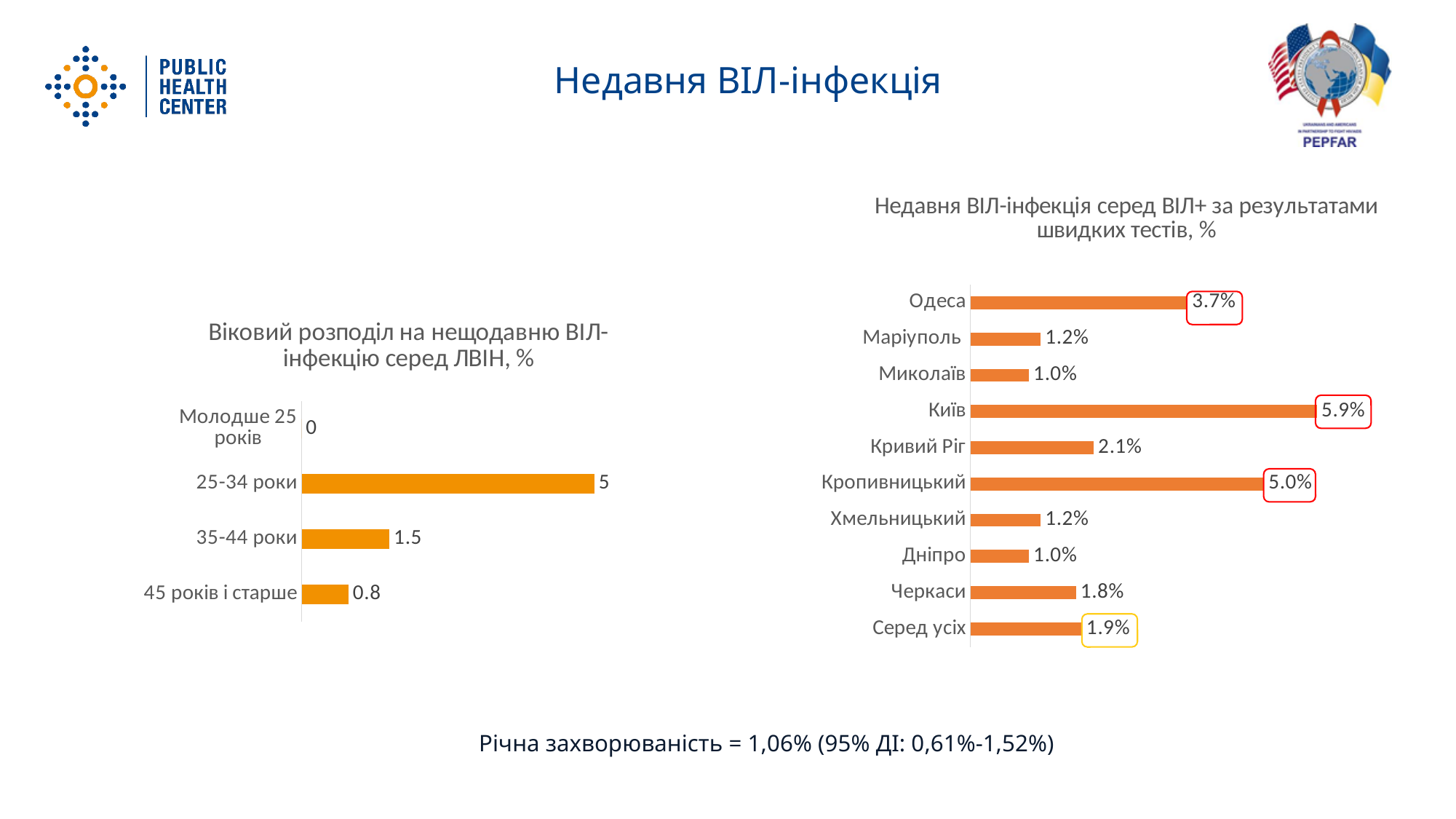
In the right chart (Недавня ВІЛ-інфекція серед ВІЛ+ за результатами швидких тестів, %), what is the value for Серед усіх? 1.9% What type of chart is the right chart (Недавня ВІЛ-інфекція серед ВІЛ+ за результатами швидких тестів, %)? Bar chart In the left chart (Віковий розподіл на нещодавню ВІЛ-інфекцію серед ЛВІН, %), what is the value for 45 років і старше? 0.8 In the left chart (Віковий розподіл на нещодавню ВІЛ-інфекцію серед ЛВІН, %), what is the value for 25-34 роки? 5 In the right chart (Недавня ВІЛ-інфекція серед ВІЛ+ за результатами швидких тестів, %), which is larger, the value for Кривий Ріг or the value for Черкаси? Кривий Ріг In the right chart (Недавня ВІЛ-інфекція серед ВІЛ+ за результатами швидких тестів, %), which city has the highest value? Київ In the right chart (Недавня ВІЛ-інфекція серед ВІЛ+ за результатами швидких тестів, %), what is the value for Київ? 5.9% In the left chart (Віковий розподіл на нещодавню ВІЛ-інфекцію серед ЛВІН, %), how many age groups are shown? 4 In the right chart (Недавня ВІЛ-інфекція серед ВІЛ+ за результатами швидких тестів, %), what is the difference between the values for Київ and Одеса? 2.2% In the left chart (Віковий розподіл на нещодавню ВІЛ-інфекцію серед ЛВІН, %), what is the difference between the values for 25-34 роки and 35-44 роки? 3.5 In the left chart (Віковий розподіл на нещодавню ВІЛ-інфекцію серед ЛВІН, %), which age group has the highest value? 25-34 роки In the right chart (Недавня ВІЛ-інфекція серед ВІЛ+ за результатами швидких тестів, %), how many categories are shown? 10